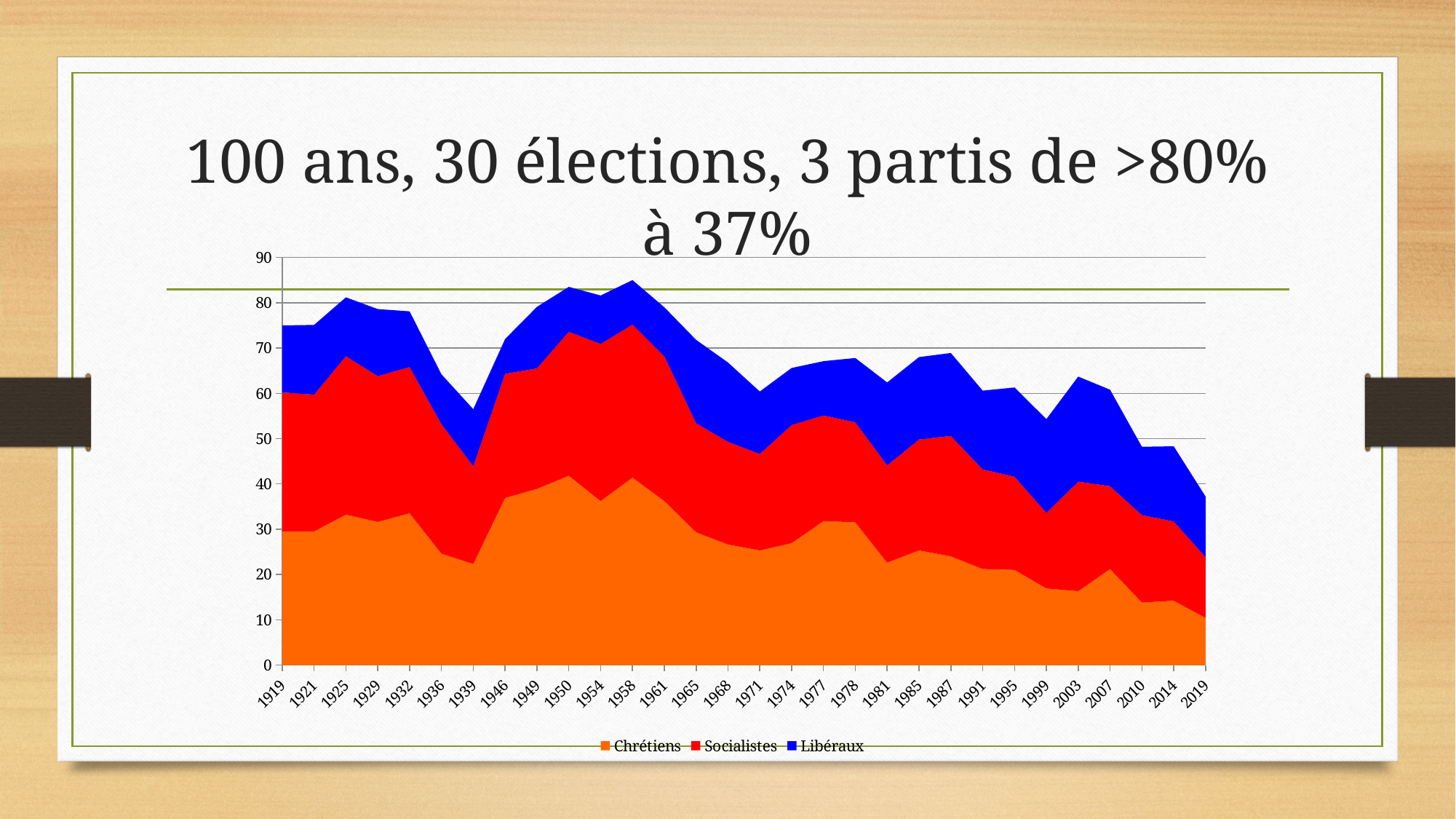
How many election years are plotted along the x axis? 30 How many series does the legend list? 3 Which series is shown in blue in the legend? Libéraux What is the first year shown on the x axis? 1919 In which year is the combined total of the three parties lowest? 2019 Overall, does the combined total of the three parties rise or fall from 1919 to 2019? fall Is the combined total of the three parties in 1971 greater or less than 50? greater Is the value for Chrétiens in 1939 greater or less than 30? less Is the combined total of the three parties in 2019 greater or less than 40? less What kind of chart is shown on the slide? Stacked area chart